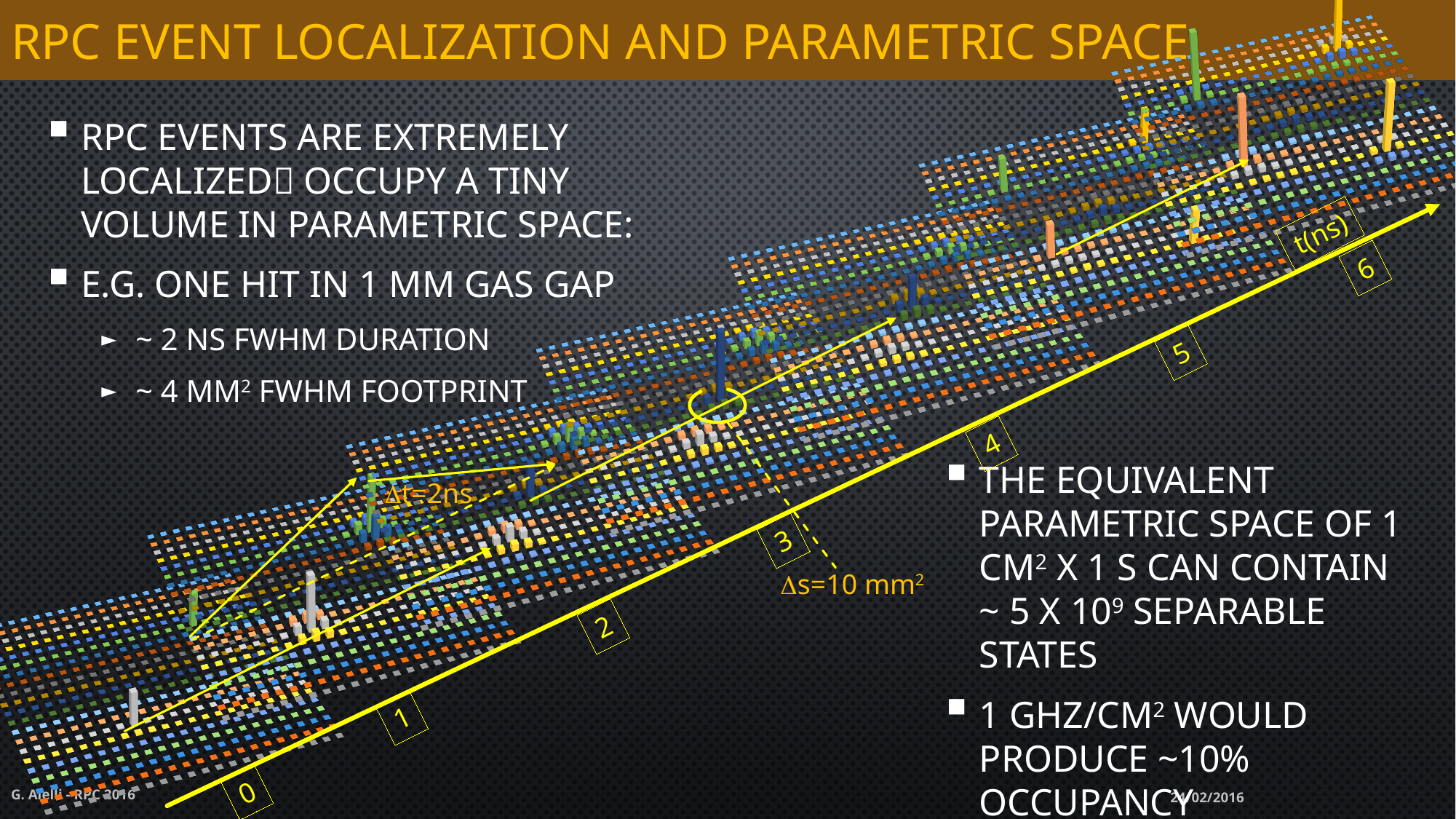
How many numbered tick labels are shown along the t(ns) axis? 7 What kind of chart is shown on the slide? 3D bar chart What is the lowest tick value shown on the t(ns) axis? 0 What unit is the time axis of the chart expressed in? ns What value is given for Δs in the annotation on the chart? 10 mm² What value is given for Δt in the annotation on the chart? 2ns What is the label of the yellow axis running along the chart? t(ns) What is the highest tick value shown on the t(ns) axis? 6